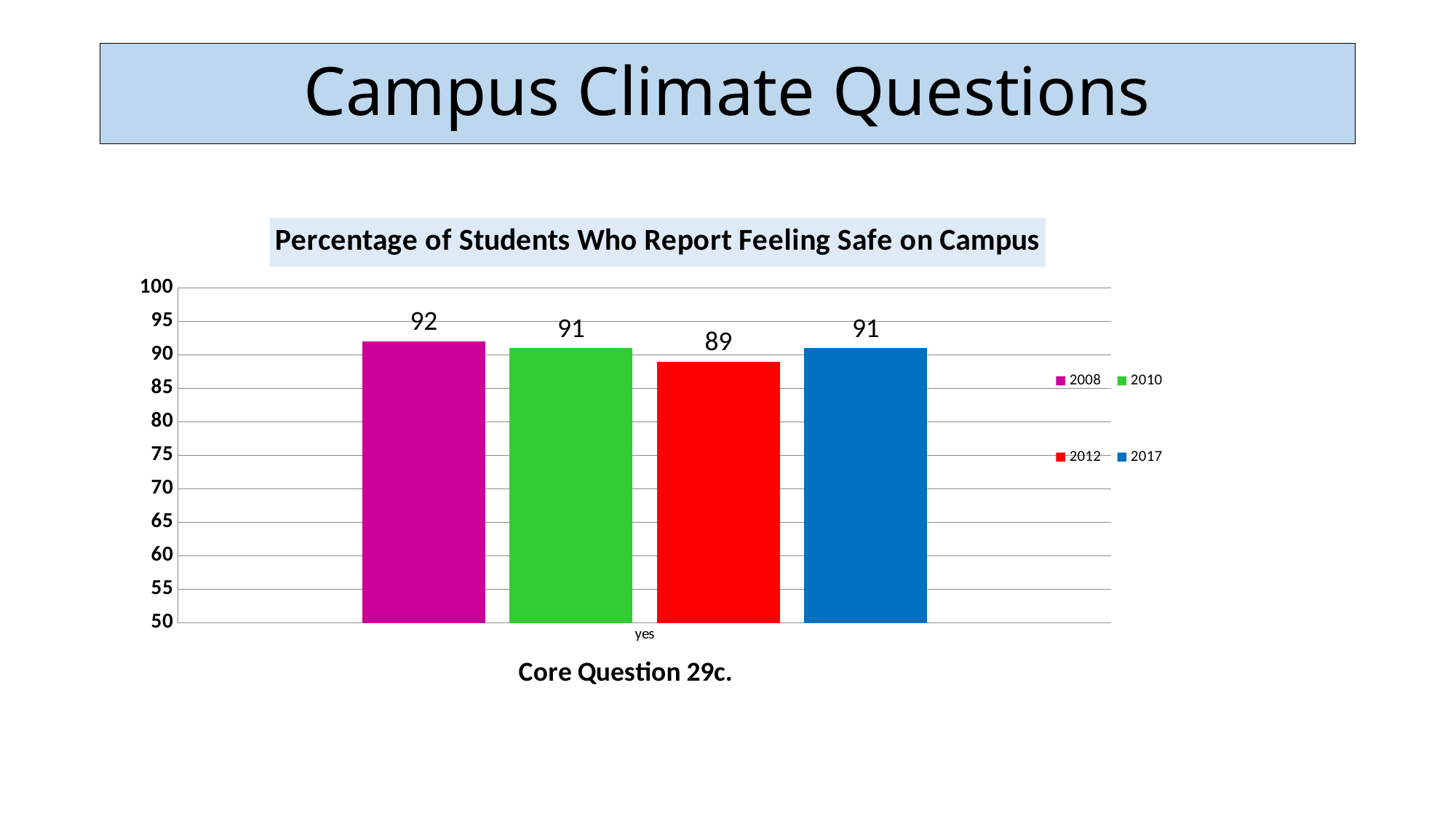
What is the value for 2012? 89 What is the value for 2008? 92 Is the value for 2012 greater or less than 85? greater What is the difference between the values for 2008 and 2012? 3 Which year has the highest value? 2008 Which is larger, the value for 2010 or the value for 2012? 2010 How many series does the legend list? 4 What kind of chart is shown? bar chart What is the value for 2017? 91 What colour is the bar for 2017? blue What is the title of the chart? Percentage of Students Who Report Feeling Safe on Campus Which year has the lowest value? 2012